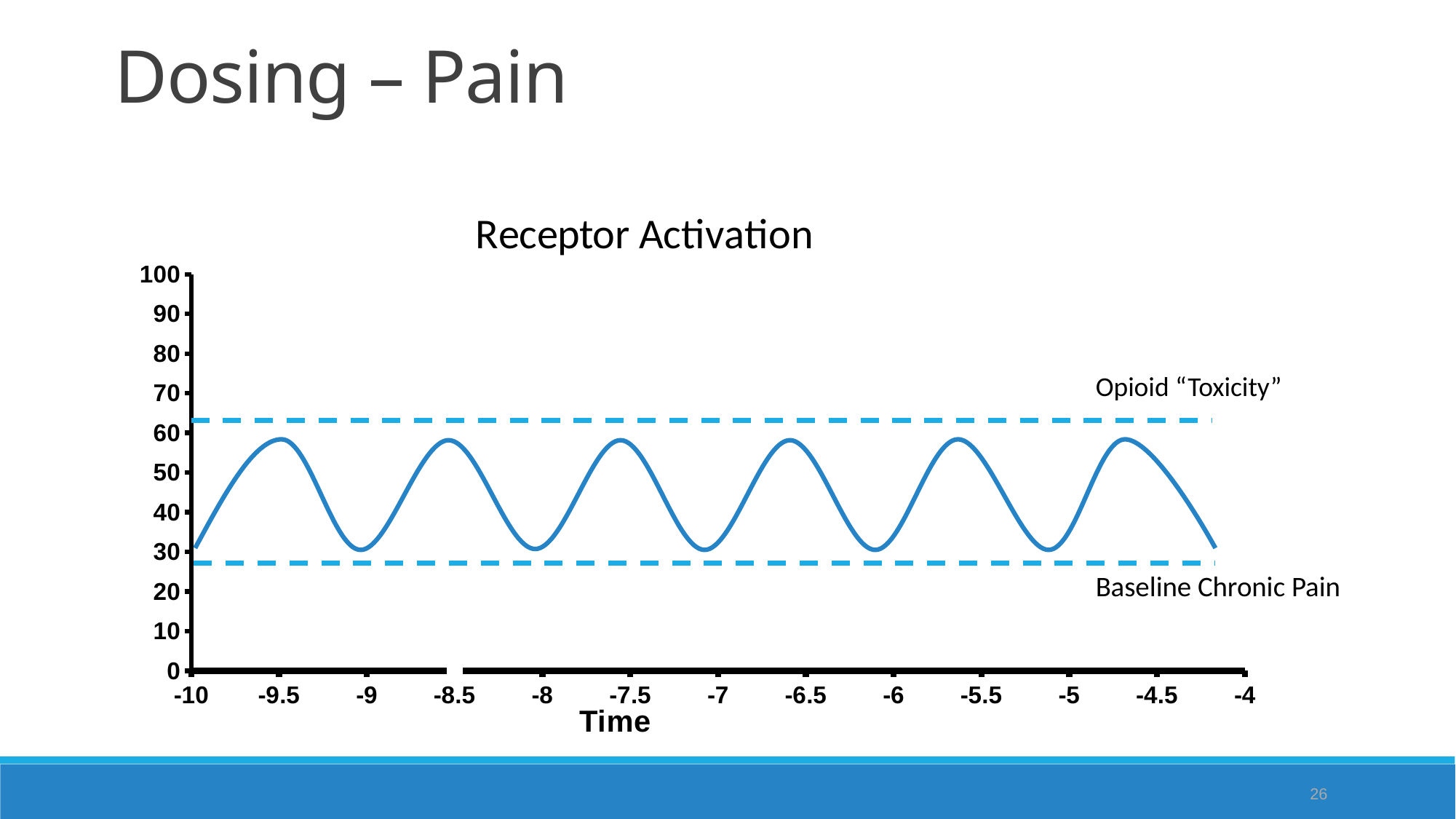
What is the label of the x axis? Time What is the leftmost value shown on the x axis? -10 Are the peaks of the solid curve greater or less than 50? greater Are the troughs of the solid curve greater or less than 20? greater Which dashed line is higher on the chart, Opioid "Toxicity" or Baseline Chronic Pain? Opioid "Toxicity" What is the highest value shown on the y axis? 100 What is the title of the chart? Receptor Activation Are the troughs of the solid curve greater or less than 40? less What kind of chart is shown on the slide? line chart How many peaks does the solid curve reach within the plotted range? 6